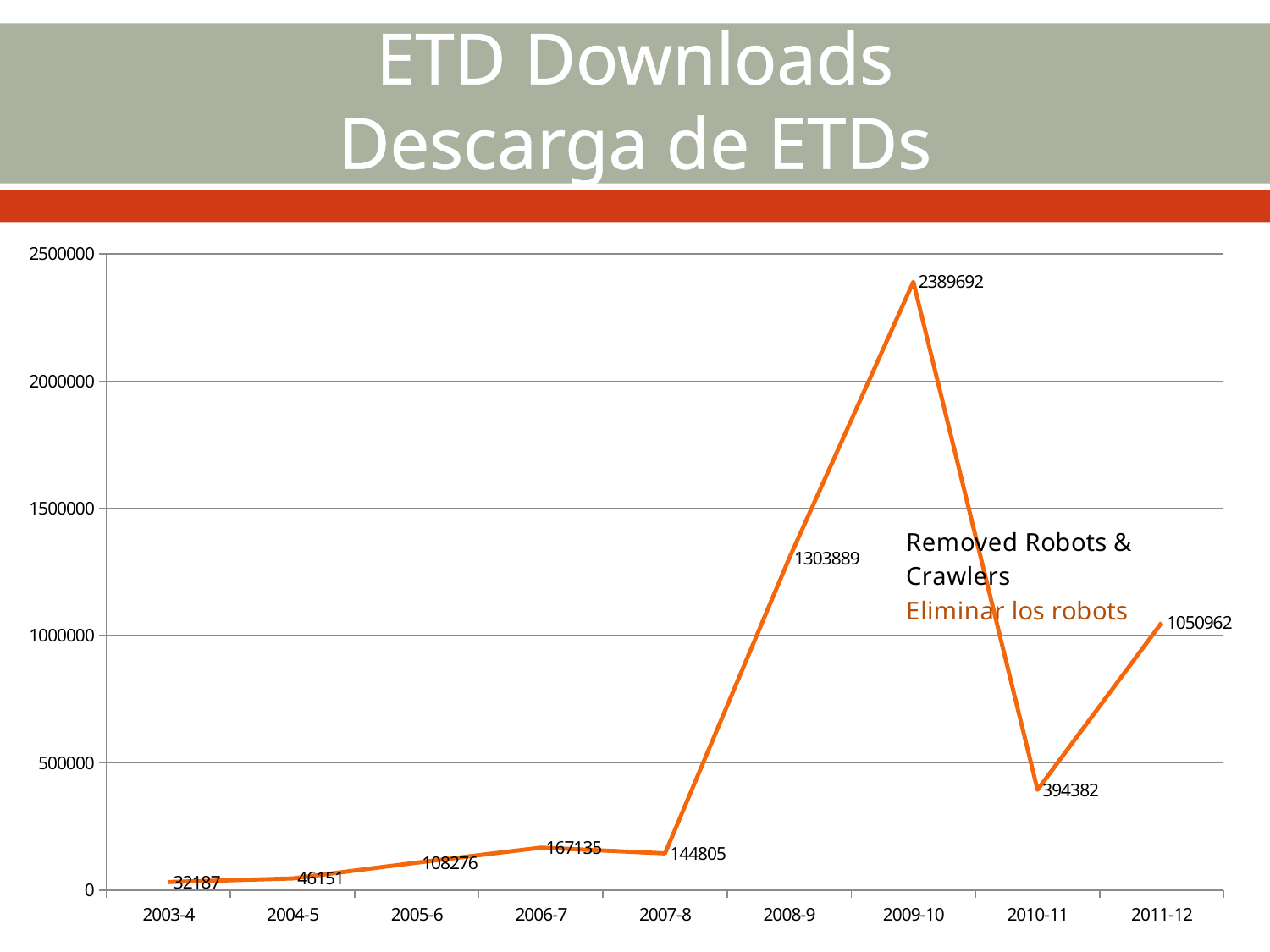
Is the value for 2008-9 greater or less than 1000000? greater What is the value for 2010-11? 394382 Which year has the lowest value? 2003-4 How many years are plotted on the chart? 9 What is the value for 2011-12? 1050962 What kind of chart is shown on the slide? line chart Which is larger, the value for 2006-7 or the value for 2007-8? 2006-7 Do the values rise or fall from 2003-4 to 2006-7? rise Which year has the highest value? 2009-10 What is the value for 2003-4? 32187 What is the value for 2009-10? 2389692 What is the difference between the values for 2009-10 and 2008-9? 1085803